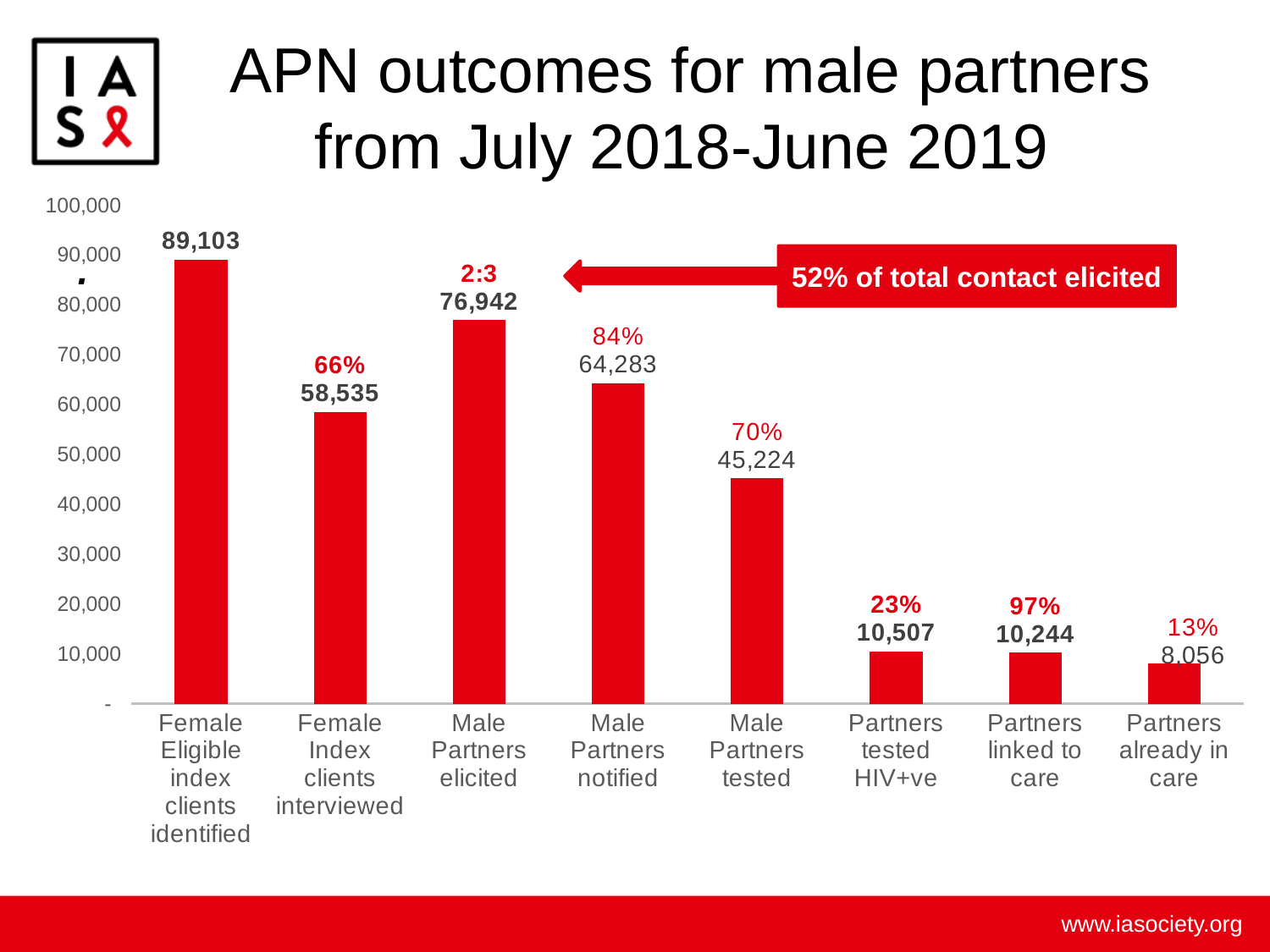
What is the value for Female Eligible index clients identified? 89,103 What is the difference between Male Partners elicited and Male Partners notified? 12,659 What percentage label is shown above the Partners tested HIV+ve bar? 23% What is the value for Partners linked to care? 10,244 How many categories are shown on the x axis? 8 What is the value for Male Partners tested? 45,224 Which is larger, Female Index clients interviewed or Male Partners tested? Female Index clients interviewed What kind of chart is shown on the slide? bar chart Which category has the lowest value? Partners already in care Which category has the highest value? Female Eligible index clients identified What is the difference between Partners tested HIV+ve and Partners linked to care? 263 Is the value for Male Partners notified greater or less than 60,000? greater